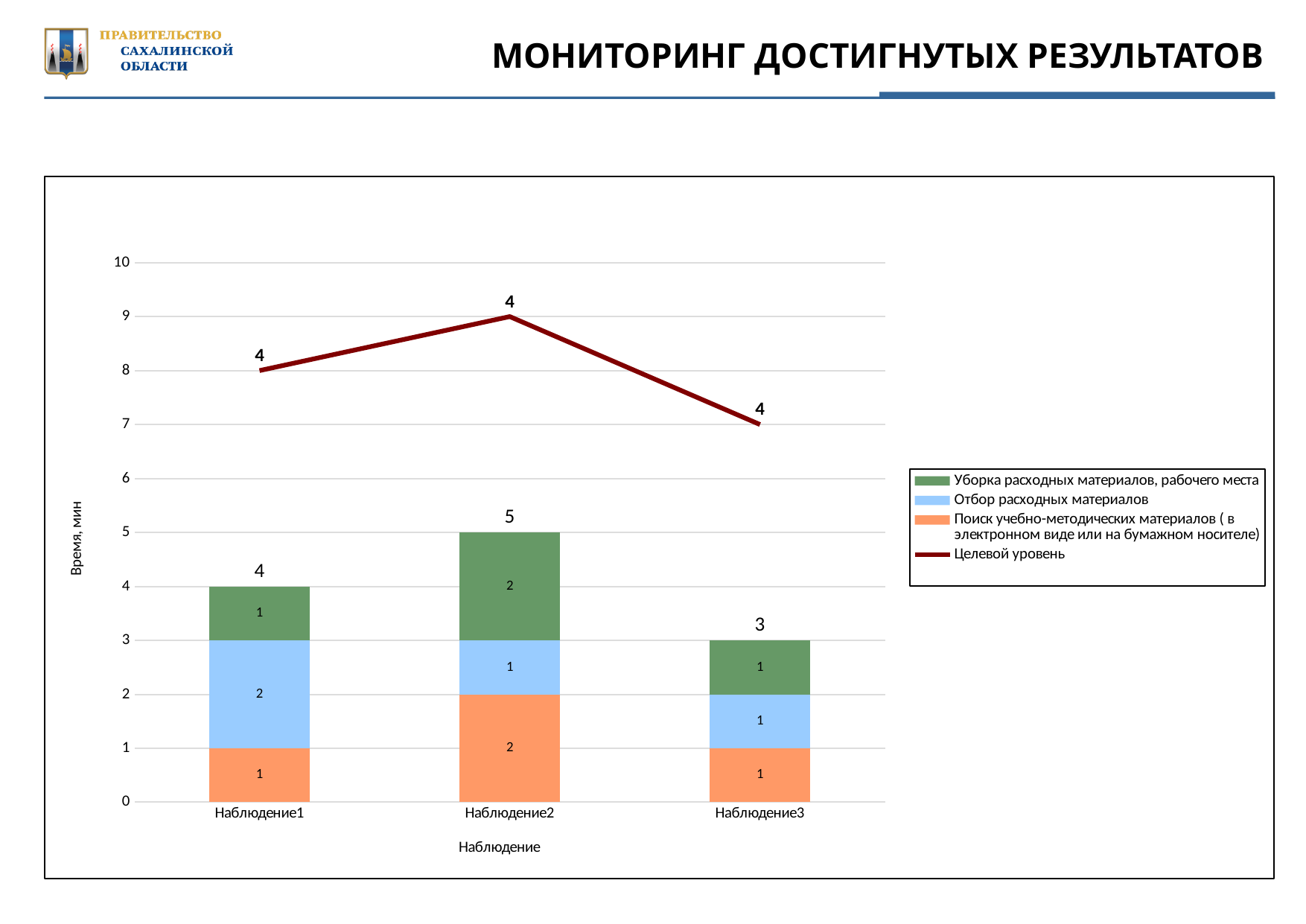
How many series does the legend list? 4 Which observation has the highest stacked bar total? Наблюдение2 What is the label of the y axis? Время, мин What is the difference between the stacked bar totals for Наблюдение2 and Наблюдение3? 2 What is the value of Отбор расходных материалов for Наблюдение1? 2 What is the total of the stacked bar for Наблюдение2? 5 What is the total of the stacked bar for Наблюдение3? 3 What is the value of Уборка расходных материалов, рабочего места for Наблюдение3? 1 What is the value of Поиск учебно-методических материалов for Наблюдение2? 2 Which observation has the lowest stacked bar total? Наблюдение3 What type of chart is shown on the slide? stacked bar chart with a line How many categories are shown on the x axis? 3